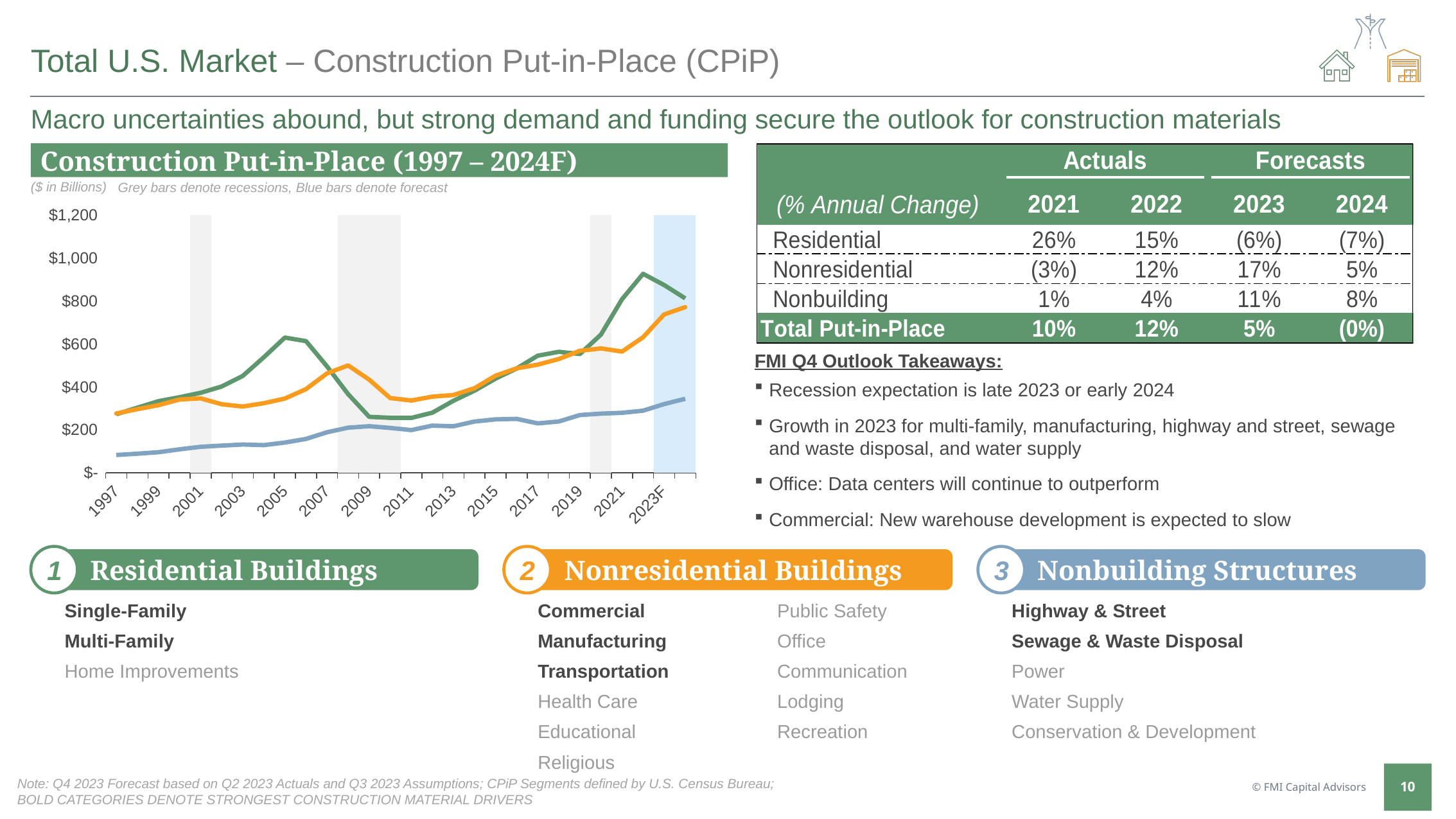
In the Construction Put-in-Place chart, which line is higher in 2005: the green (Residential) line or the orange (Nonresidential) line? green (Residential) In the Construction Put-in-Place chart, which line has the lowest values across the whole period? blue (Nonbuilding) In the Construction Put-in-Place chart, is the green (Residential) line's value in 2011 greater or less than $400? less What kind of chart is the Construction Put-in-Place (1997 – 2024F) chart? combination bar and line chart What unit is used for the values in the Construction Put-in-Place chart? $ in Billions In the Construction Put-in-Place chart, is the orange (Nonresidential) line's value in 2023F greater or less than $600? greater In the Construction Put-in-Place chart, what do the grey bars denote? recessions How many lines are plotted on the Construction Put-in-Place chart? 3 In the Construction Put-in-Place chart, does the green (Residential) line rise or fall between 2011 and 2021? rise In the Construction Put-in-Place chart, is the blue (Nonbuilding) line's value in 2023F greater or less than $400? less In the Construction Put-in-Place chart, which line is higher in 2009: the green (Residential) line or the orange (Nonresidential) line? orange (Nonresidential)